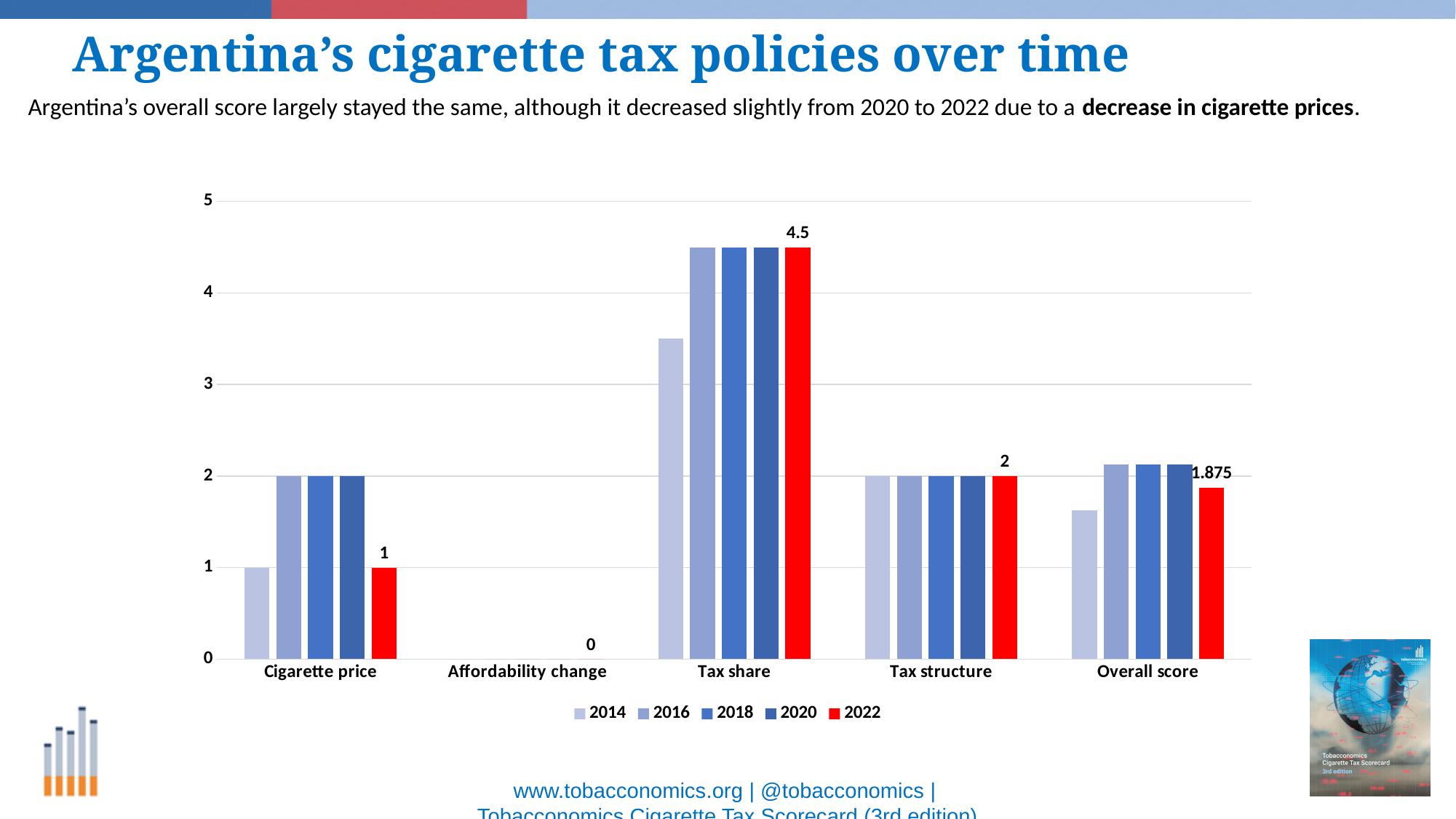
What is the 2022 value for Affordability change? 0 Which category has the highest 2022 value? Tax share What is the 2022 value for Tax share? 4.5 What is the 2022 value for Tax structure? 2 What is the 2022 value for Cigarette price? 1 What is the difference between the 2022 values for Tax share and Tax structure? 2.5 Which is larger in 2022: Tax structure or Overall score? Tax structure Is the 2014 value for Tax share greater or less than 3? greater Which category has the lowest 2022 value? Affordability change What is the 2022 value for Overall score? 1.875 What kind of chart is shown on the slide? bar chart How many series does the legend list? 5